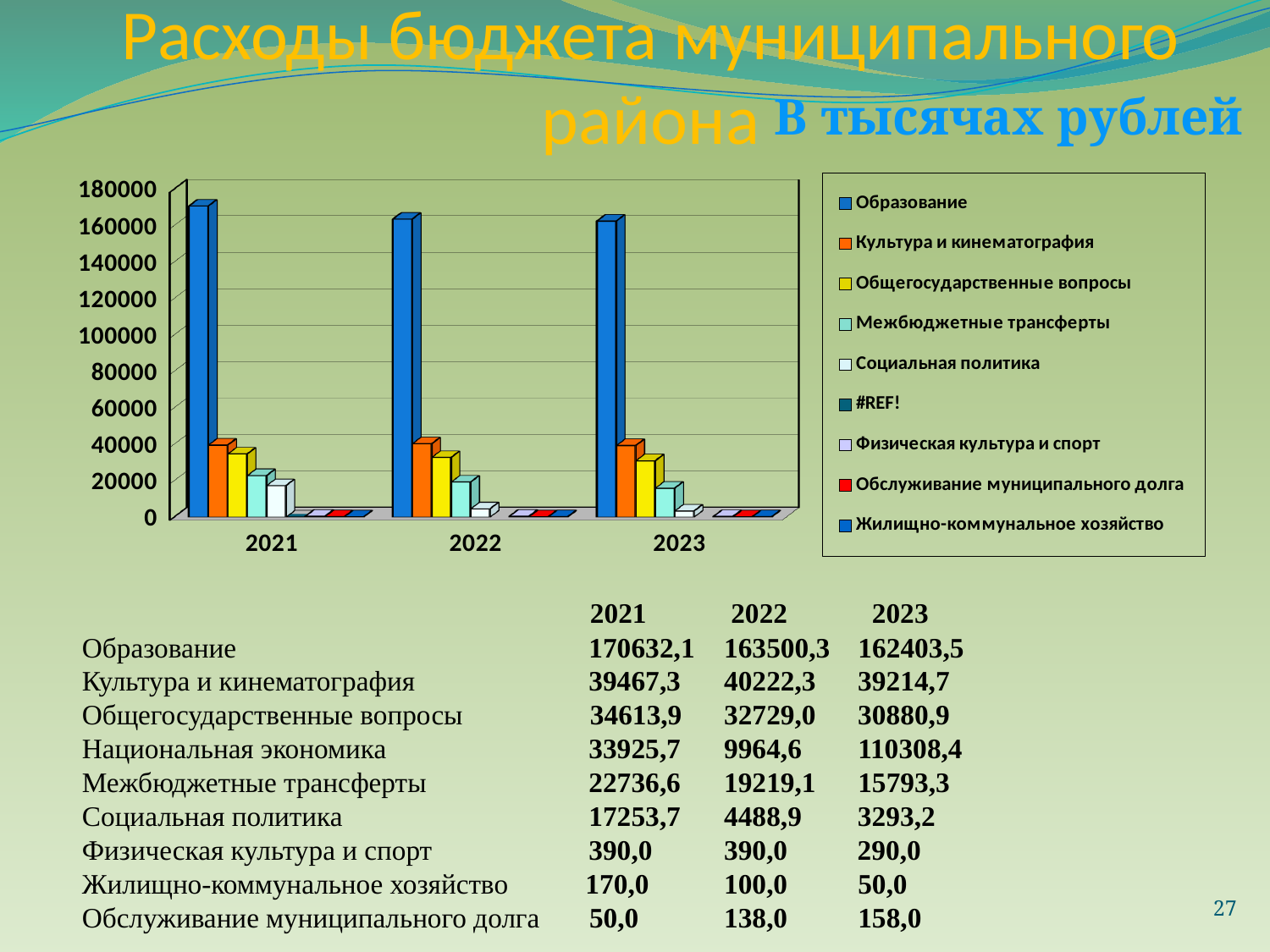
What kind of chart is shown on the slide? bar chart In which year is the Образование bar the highest? 2021 How many series does the chart legend list? 9 What is the difference between Образование in 2021 and in 2023? 8228,6 Is the value for Межбюджетные трансферты in 2023 greater or less than 20000? less What is the value for Культура и кинематография in 2022? 40222,3 Which legend entry shows an error reference instead of a category name? #REF! Which is larger, Социальная политика in 2021 or in 2022? 2021 Do the Образование values rise or fall from 2021 to 2023? fall What is the value for Образование in 2021? 170632,1 Is the value for Образование in 2022 greater or less than 140000? greater How many years are shown on the x axis of the chart? 3